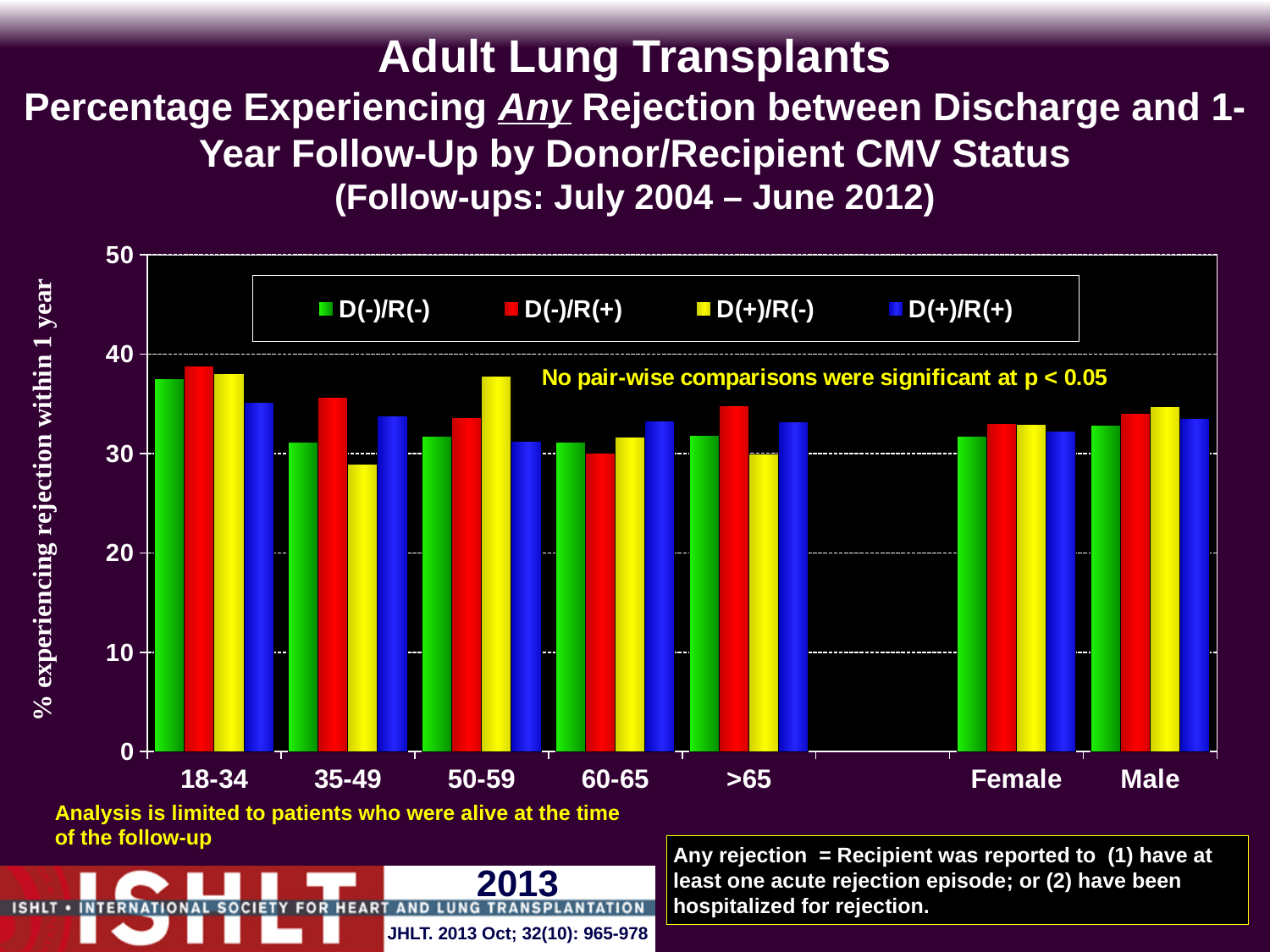
Is the value for D(-)/R(-) in the 18-34 age group greater or less than 30? greater How many categories are shown along the x axis? 7 Is the value for D(-)/R(+) in the 18-34 age group greater or less than 40? less Which CMV status group has the highest value in the 50-59 age group? D(+)/R(-) In the 50-59 age group, which is larger: D(+)/R(-) or D(+)/R(+)? D(+)/R(-) What is the label of the y axis? % experiencing rejection within 1 year Is the value for D(+)/R(+) in the 18-34 age group greater or less than 30? greater What kind of chart is shown on the slide? Bar chart In the 35-49 age group, which is larger: D(-)/R(+) or D(+)/R(-)? D(-)/R(+) Which CMV status group has the lowest value in the 35-49 age group? D(+)/R(-) How many series does the legend list? 4